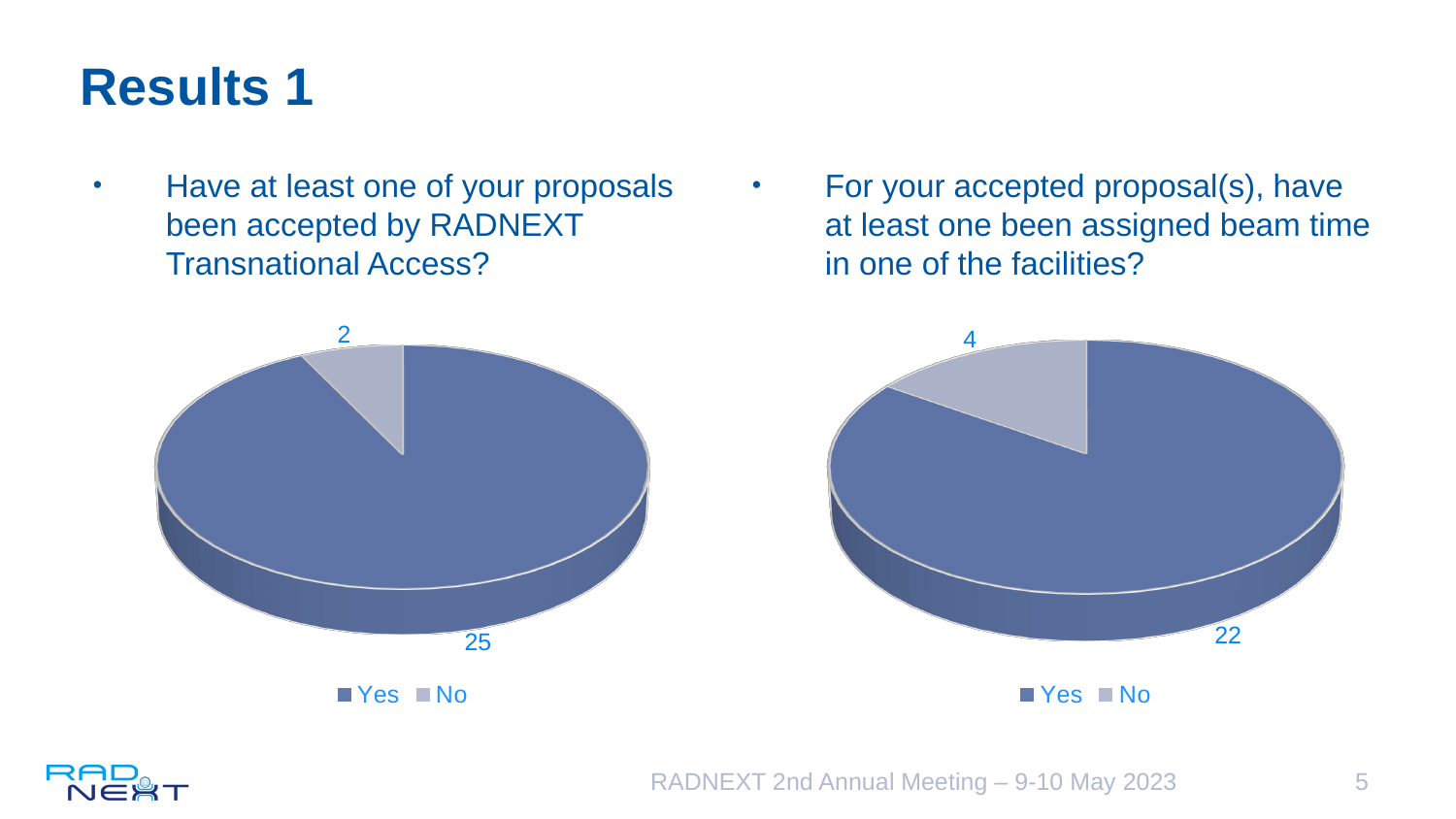
Is the No count larger in the left pie chart or the right pie chart? Right pie chart In the left pie chart, what is the difference between the Yes and No counts? 23 In the left pie chart, how many respondents answered Yes? 25 How many entries does the legend of the right pie chart list? 2 What type of chart is used on the left of the slide? Pie chart In the right pie chart, how many respondents answered Yes? 22 In the right pie chart, what is the difference between the Yes and No counts? 18 In the right pie chart, how many respondents answered No? 4 What is the total number of responses shown in the right pie chart? 26 In the right pie chart, which category has the smallest slice? No In the left pie chart, how many respondents answered No? 2 In the left pie chart, which category has the largest slice? Yes